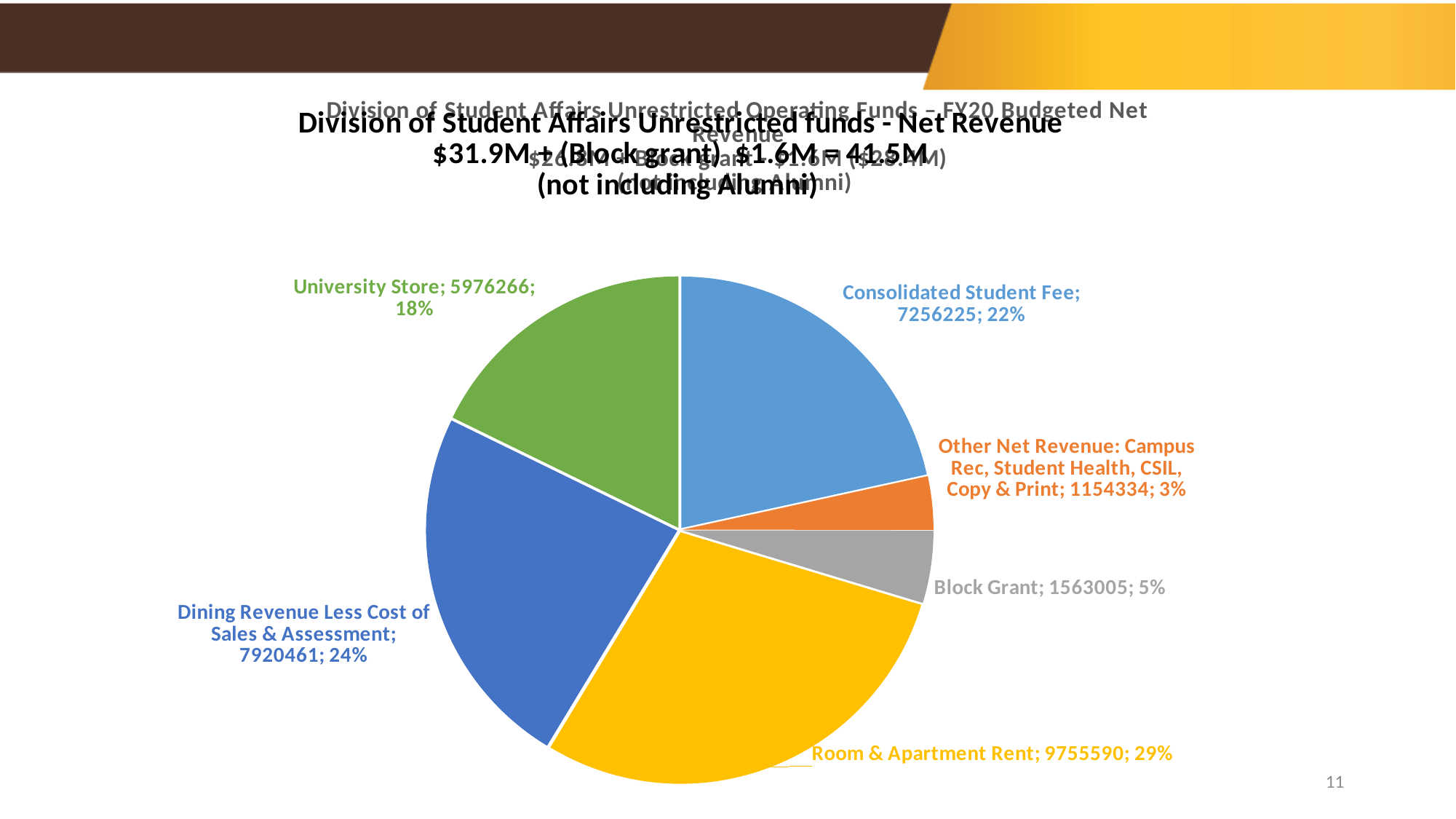
What is the difference between the Room & Apartment Rent value and the University Store value? 3779324 What share of the pie does Dining Revenue Less Cost of Sales & Assessment represent? 24% Which is larger, Dining Revenue Less Cost of Sales & Assessment or Consolidated Student Fee? Dining Revenue Less Cost of Sales & Assessment What share of the pie does University Store represent? 18% What is the value for Consolidated Student Fee? 7256225 What colour is the Block Grant slice? grey Which category has the smallest slice of the pie? Other Net Revenue: Campus Rec, Student Health, CSIL, Copy & Print What is the value for Room & Apartment Rent? 9755590 What kind of chart is shown on the slide? pie chart How many slices does the pie chart have? 6 Which category has the largest slice of the pie? Room & Apartment Rent What is the value for Block Grant? 1563005